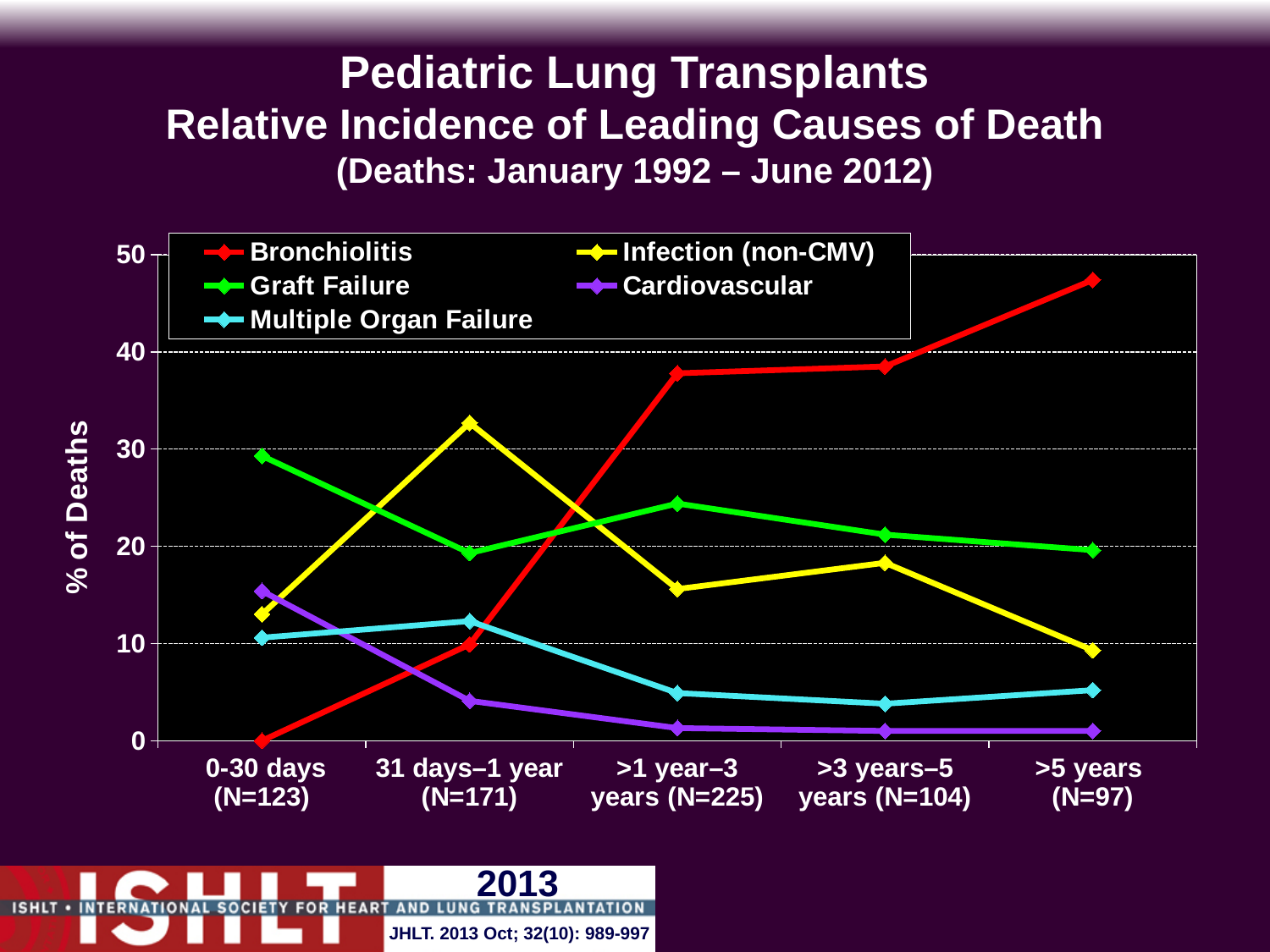
Does the Cardiovascular line rise or fall from 0-30 days to >5 years? fall What kind of chart is shown on the slide? line chart How many series does the legend list? 5 Is the value for Graft Failure in the 0-30 days period greater or less than 20? greater What is the label on the y axis? % of Deaths Which cause of death has the highest % of deaths in the >5 years (N=97) period? Bronchiolitis Is the value for Bronchiolitis in the >5 years period greater or less than 40? greater Which cause of death has the lowest % of deaths in the >5 years (N=97) period? Cardiovascular Is the value for Infection (non-CMV) in the 31 days–1 year period greater or less than 30? greater In the >1 year–3 years period, which is larger: Graft Failure or Infection (non-CMV)? Graft Failure Which cause of death has the highest % of deaths in the 0-30 days (N=123) period? Graft Failure How many time-period categories are shown on the x axis? 5